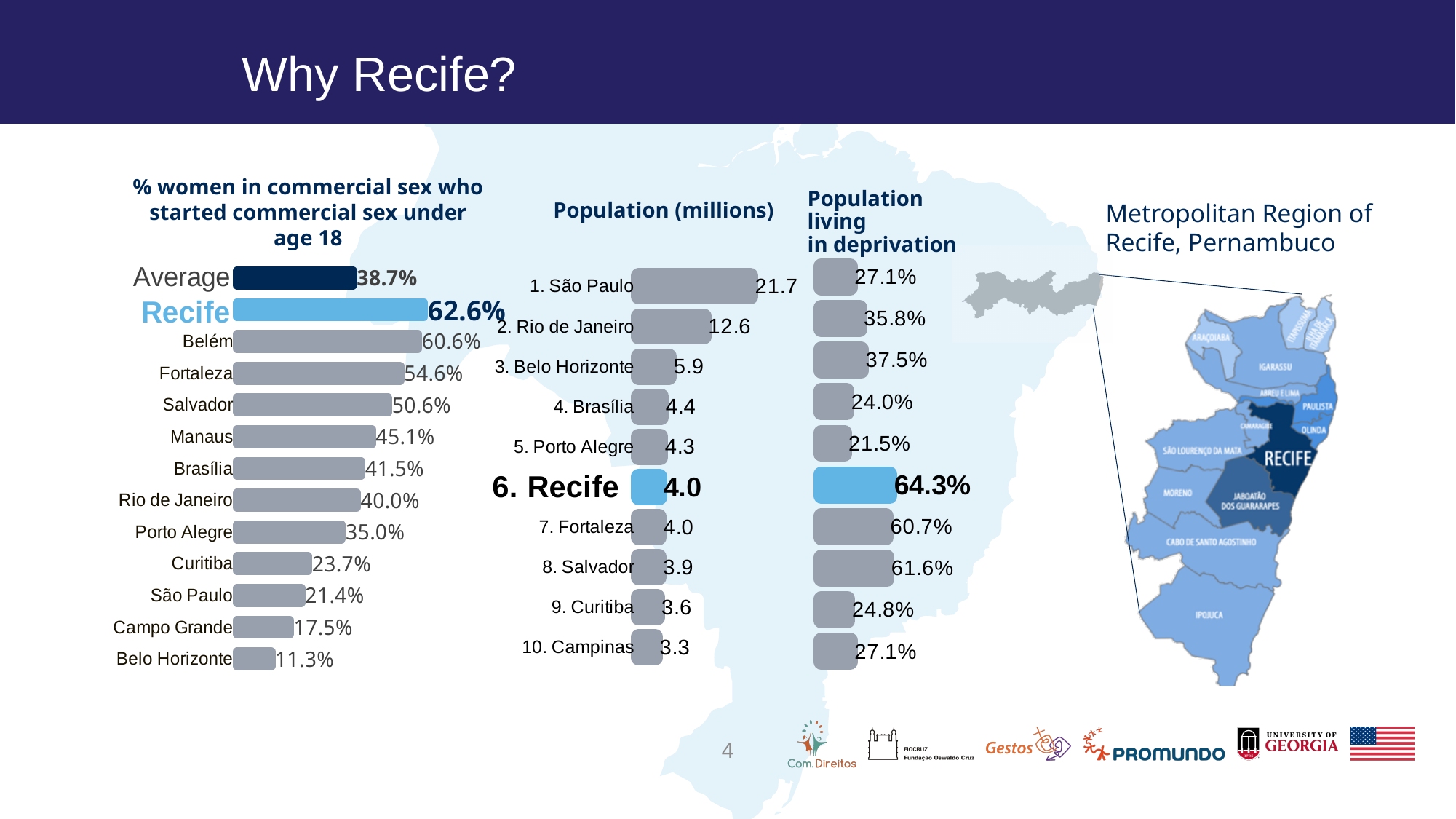
In the 'Population (millions)' chart, which city has the smallest population? Campinas In the 'Population living in deprivation' chart, what is the value for Recife? 64.3% In the 'Population (millions)' chart, what is the value for Recife? 4.0 In the '% women in commercial sex who started commercial sex under age 18' chart, how many cities (excluding Average) are listed? 12 In the 'Population (millions)' chart, what is the difference between São Paulo and Rio de Janeiro? 9.1 What kind of chart is the 'Population (millions)' chart? Bar chart In the 'Population (millions)' chart, what is the value for São Paulo? 21.7 In the '% women in commercial sex who started commercial sex under age 18' chart, which city has the lowest value? Belo Horizonte In the '% women in commercial sex who started commercial sex under age 18' chart, what is the value for Average? 38.7% In the '% women in commercial sex who started commercial sex under age 18' chart, what is the value for Recife? 62.6% In the 'Population living in deprivation' chart, which city has the highest value? Recife In the '% women in commercial sex who started commercial sex under age 18' chart, what is the difference between Recife and the Average? 23.9%